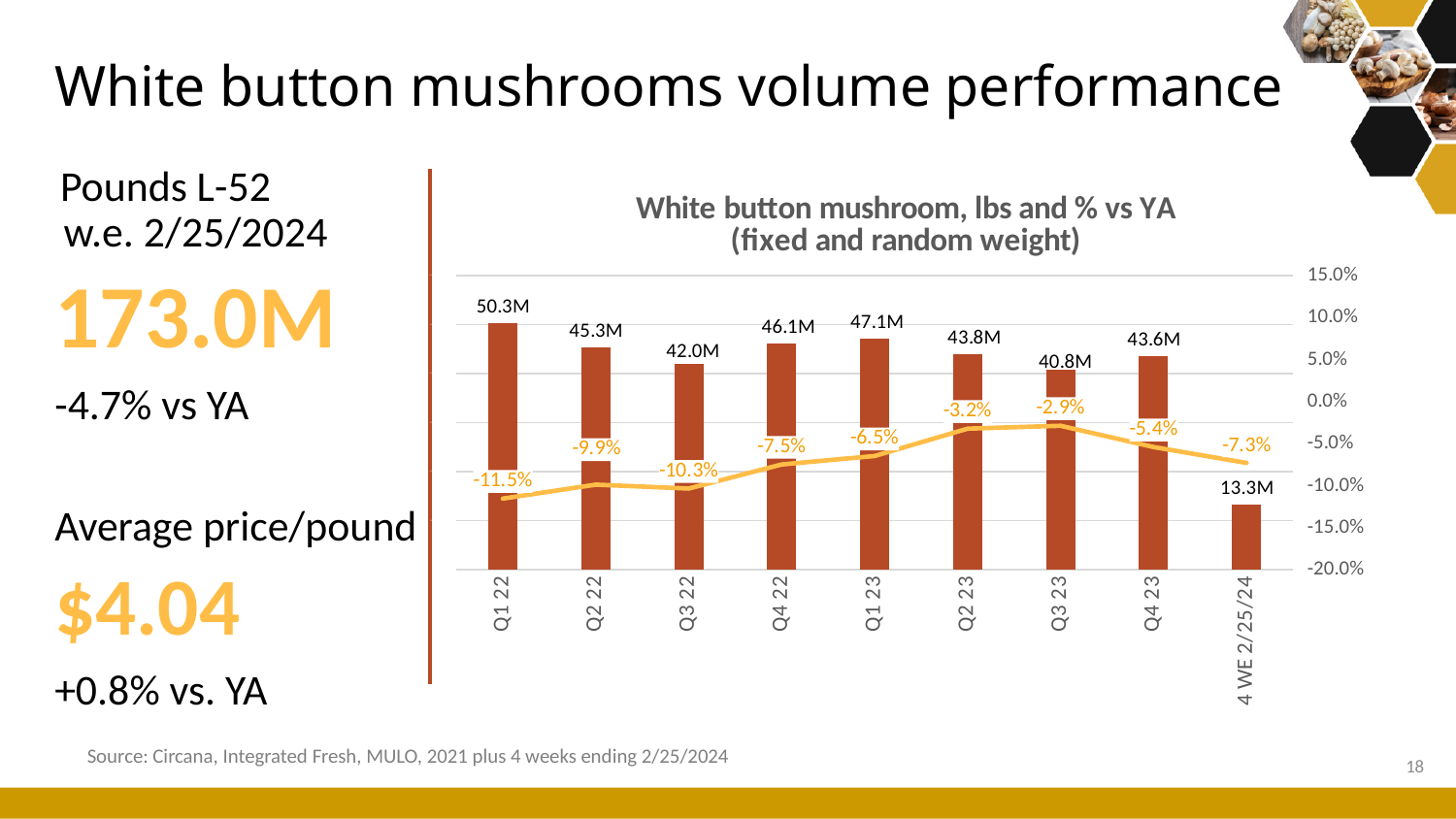
Which period has the lowest % vs YA value? Q1 22 How many periods are shown on the x axis? 9 What is the volume in pounds for Q1 22? 50.3M What is the volume in pounds for the 4 WE 2/25/24 period? 13.3M Which quarter has the highest volume in pounds? Q1 22 What is the % vs YA value for Q3 23? -2.9% Which has the larger volume in pounds, Q4 22 or Q4 23? Q4 22 What kind of chart is shown on the slide? Combination bar and line chart Does the % vs YA line rise or fall from Q1 22 to Q3 23? Rise What is the title of the chart? White button mushroom, lbs and % vs YA (fixed and random weight) What is the % vs YA value for Q2 22? -9.9% What is the difference in pounds between Q1 23 and Q2 23? 3.3M